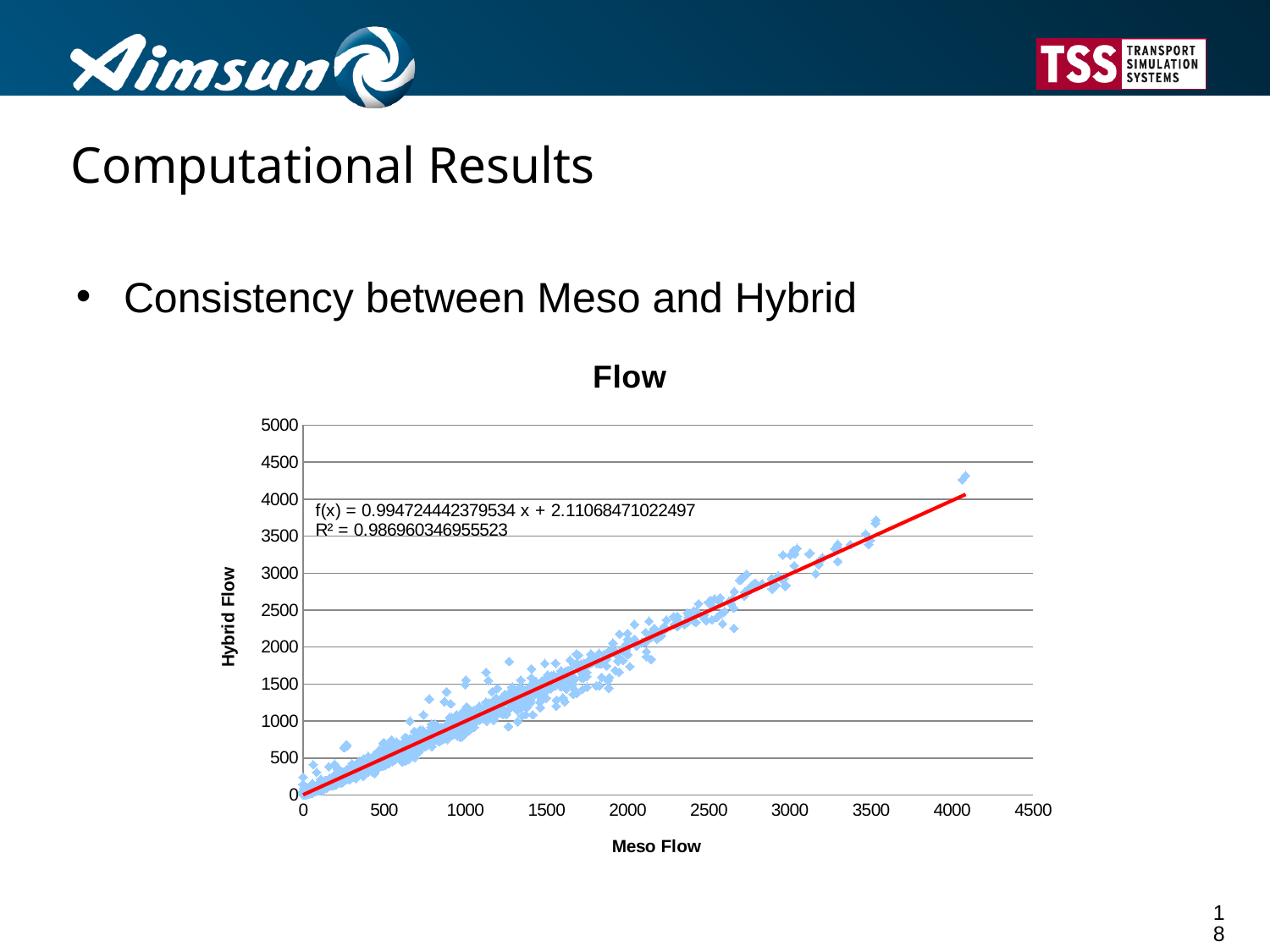
What kind of chart is shown on the slide? scatter chart Do the Hybrid Flow values rise or fall as Meso Flow increases along the x axis? rise What is the slope of the fitted line f(x) printed on the chart? 0.994724442379534 Is the R² value of the fitted line greater or less than 0.9? greater What is the highest tick value shown on the y axis (Hybrid Flow)? 5000 What is the intercept of the fitted line f(x) printed on the chart? 2.11068471022497 What is the title of the chart? Flow Is the Hybrid Flow value of the point with the largest Meso Flow greater or less than 4000? greater What is the highest tick value shown on the x axis (Meso Flow)? 4500 What is the label of the x axis of the chart? Meso Flow Is the Meso Flow value of the rightmost data point greater or less than 4500? less What R² value is printed on the chart for the fitted line? R² = 0.986960346955523